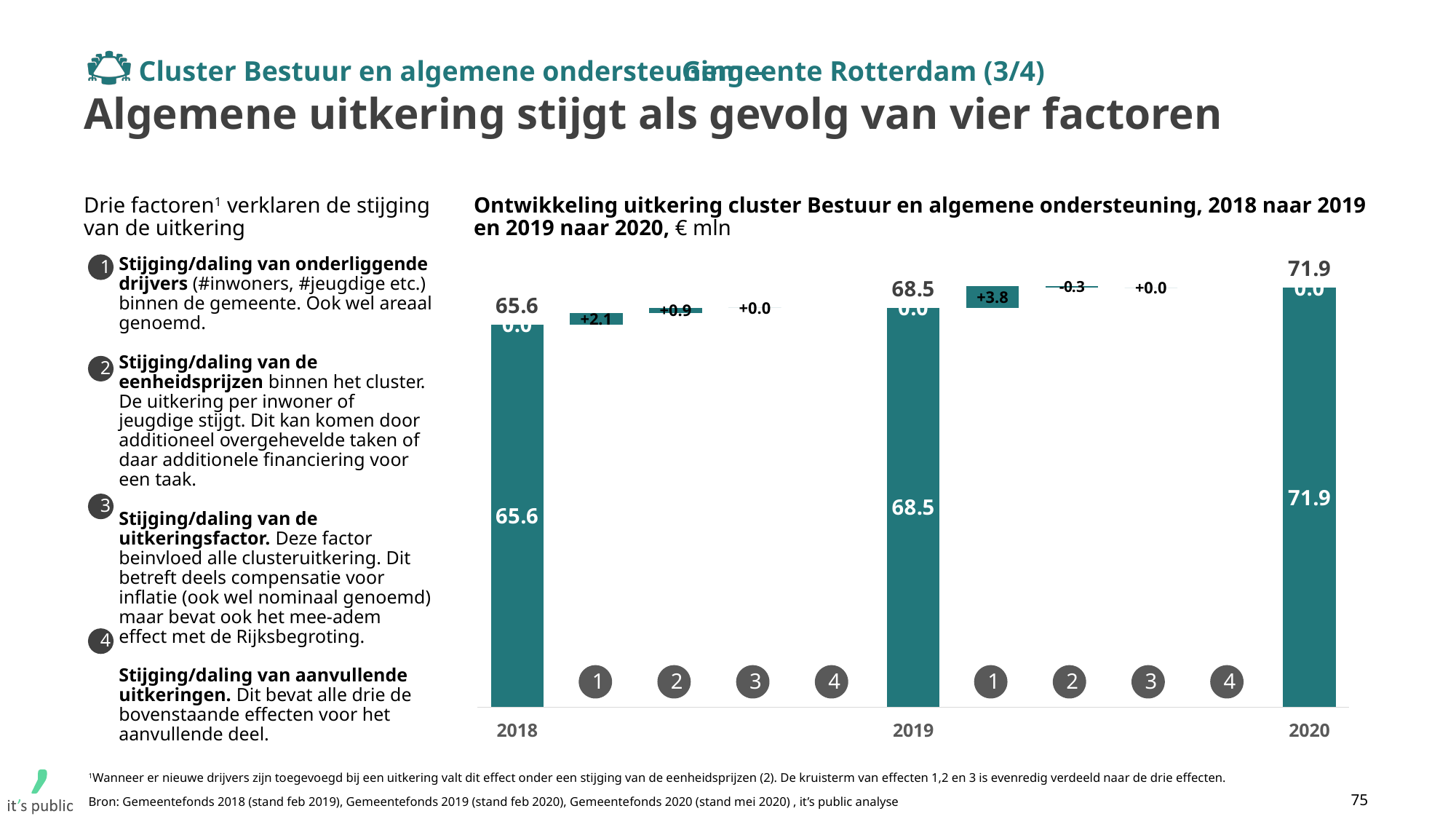
What is the value of the bar for 2020? 71.9 What is the value of factor 2 between 2018 and 2019? +0.9 What unit is stated in the chart title? € mln What is the value of factor 2 between 2019 and 2020? -0.3 What is the difference between the 2020 bar and the 2018 bar? 6.3 What is the value of factor 1 between 2018 and 2019? +2.1 Which year has the highest total bar? 2020 What is the value of the bar for 2018? 65.6 Which year has the lowest total bar? 2018 What is the value of the bar for 2019? 68.5 Do the year totals rise or fall from 2018 to 2020? rise What is the value of factor 1 between 2019 and 2020? +3.8